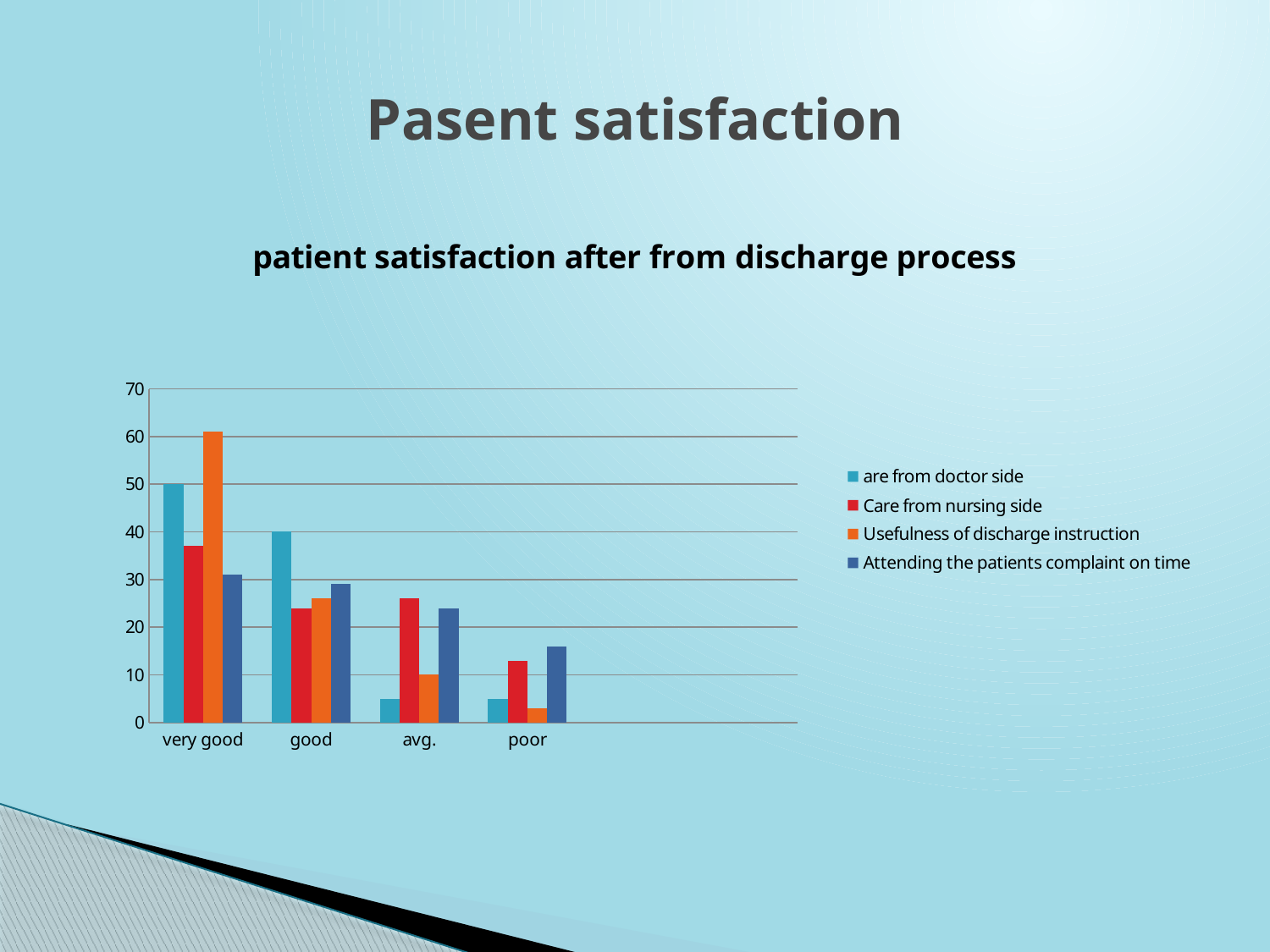
How many categories are shown on the x axis? 4 Do the values for 'are from doctor side' rise or fall from 'very good' to 'poor'? fall Which series has the lowest bar in the 'poor' category? Usefulness of discharge instruction What is the value for 'are from doctor side' in the 'good' category? 40 What is the value for 'are from doctor side' in the 'very good' category? 50 What is the title shown above the chart? patient satisfaction after from discharge process How many series does the legend list? 4 In the 'avg.' category, which is larger: 'are from doctor side' or 'Care from nursing side'? Care from nursing side Which series has the highest bar in the 'very good' category? Usefulness of discharge instruction Is the value for 'Care from nursing side' in the 'poor' category greater or less than 20? less What kind of chart is shown on the slide? bar chart